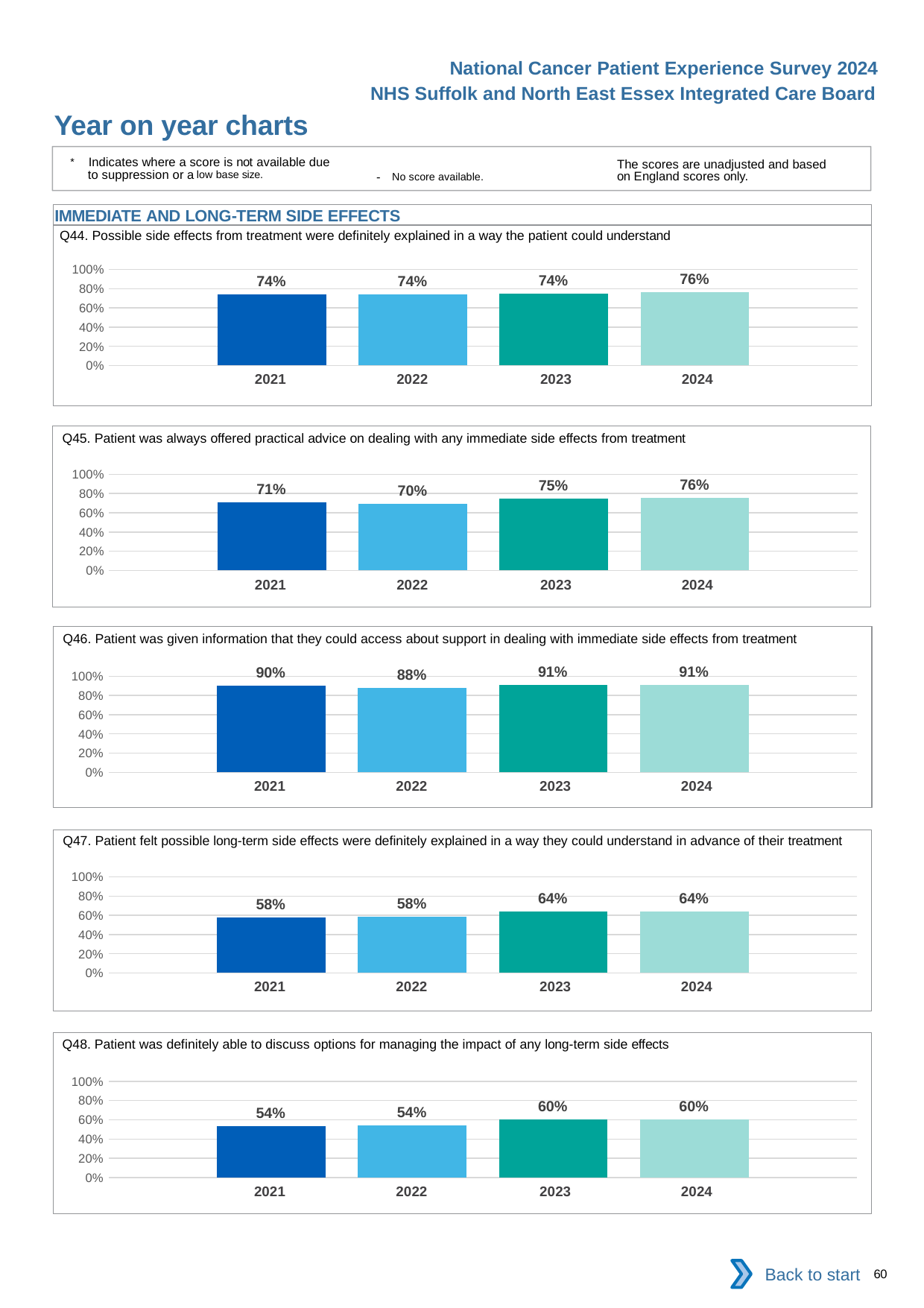
In the Q45 chart, which year has the lowest value? 2022 In the Q48 chart, do the values generally rise or fall from 2021 to 2024? Rise In the Q47 chart, what is the difference between the 2023 and 2022 values? 6 percentage points What kind of chart is the Q45 chart? Bar chart In the Q45 chart, what is the difference between the 2024 and 2021 values? 5 percentage points In the Q44 chart, what is the value for 2024? 76% In the Q48 chart, what is the value for 2021? 54% In the Q48 chart, is the value for 2024 greater or less than 40%? greater In the Q47 chart, which is larger, the value for 2021 or the value for 2023? 2023 How many years are shown on the x axis of the Q44 chart? 4 In the Q46 chart, what is the value for 2022? 88% In the Q46 chart, is the value for 2021 greater or less than 80%? greater